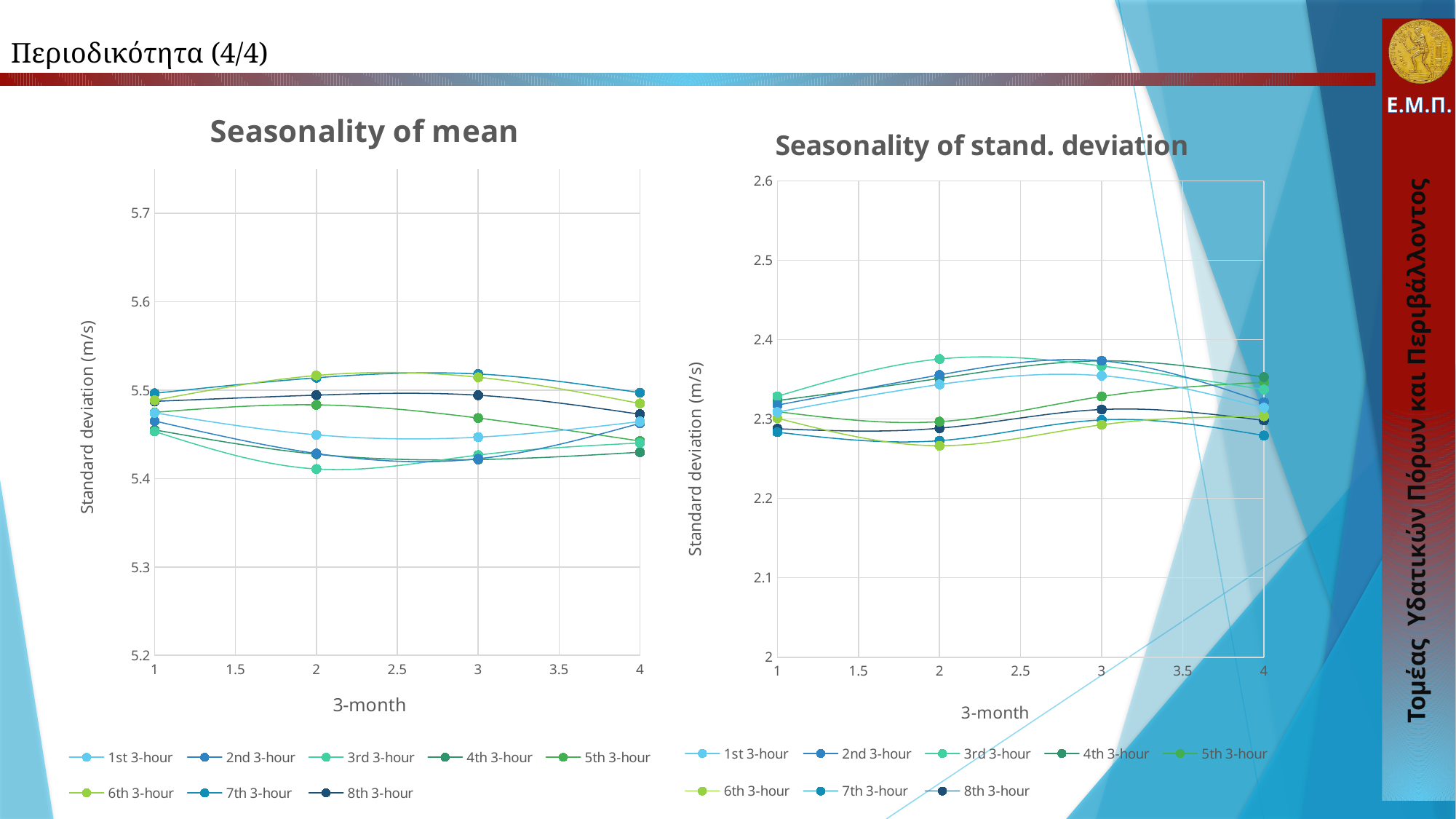
In the "Seasonality of mean" chart, how many 3-month points are plotted for each series? 4 What kind of chart is the "Seasonality of mean" chart on the left? line chart In the "Seasonality of stand. deviation" chart, is the value for 3rd 3-hour at 3-month 2 greater or less than 2.3? greater In the "Seasonality of stand. deviation" chart, is the value for 6th 3-hour at 3-month 2 greater or less than 2.3? less What is the x-axis title of the "Seasonality of stand. deviation" chart? 3-month In the "Seasonality of mean" chart, is the value for 6th 3-hour at 3-month 2 greater or less than 5.6? less In the "Seasonality of stand. deviation" chart, which series has the lowest value at 3-month 2? 6th 3-hour How many series does the legend of the "Seasonality of stand. deviation" chart list? 8 In the "Seasonality of mean" chart, does the 3rd 3-hour series rise or fall from 3-month 1 to 3-month 2? fall In the "Seasonality of mean" chart, which series has the lowest value at 3-month 2? 3rd 3-hour In the "Seasonality of mean" chart, at 3-month 2, which is larger: 6th 3-hour or 3rd 3-hour? 6th 3-hour